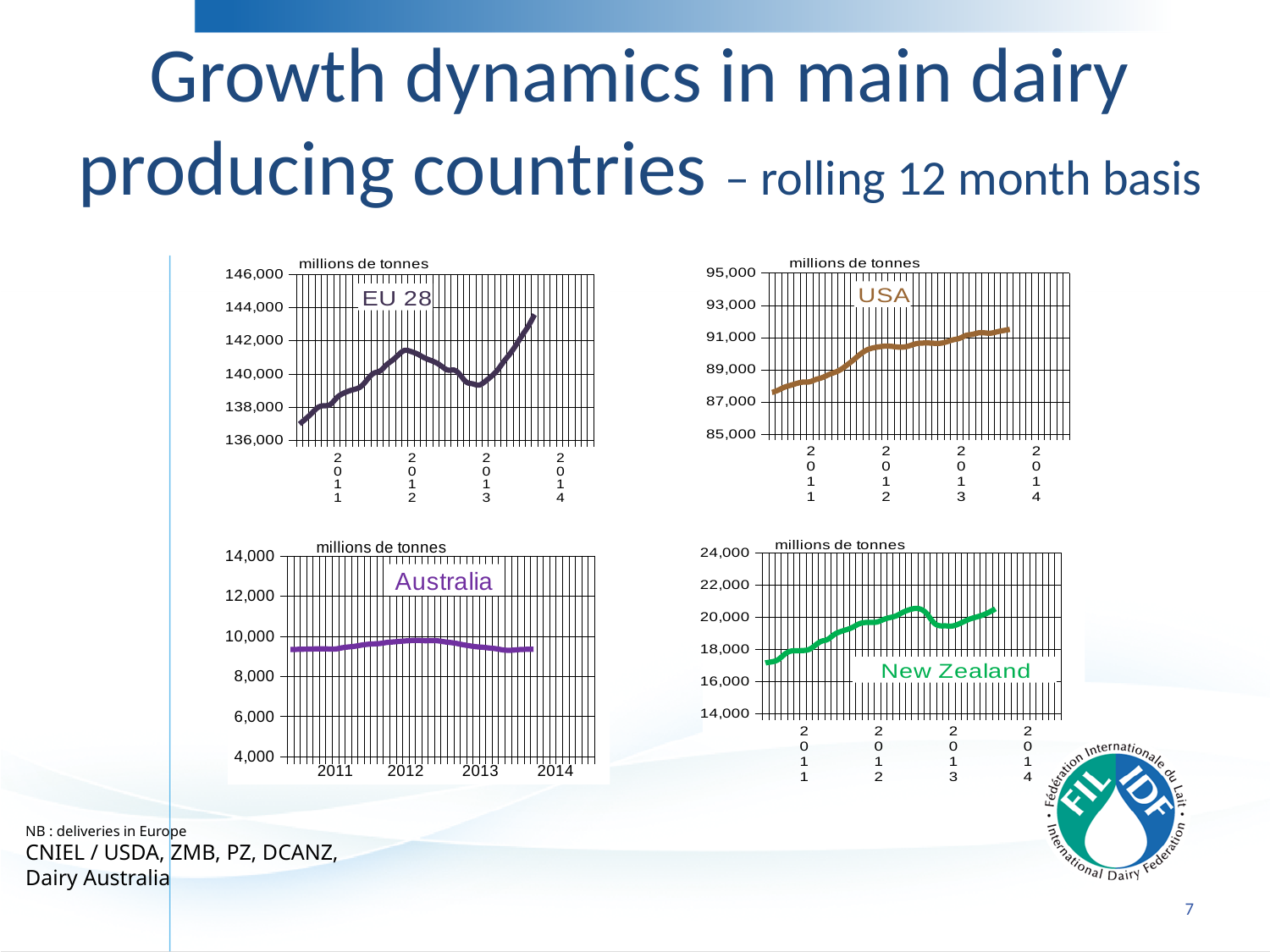
Which country is plotted in the chart at the bottom right of the slide? New Zealand In the USA chart, is the final value in 2014 greater or less than 89,000? greater What unit is shown above each of the four charts? millions de tonnes In the New Zealand chart at the bottom right, is the value at the start of 2011 greater or less than 18,000? less What kind of chart is the EU 28 chart at the top left? line chart In the New Zealand chart, is the peak value reached in 2012 greater or less than 20,000? greater How many charts are shown on the slide? 4 In the USA chart at the top right, does the line rise or fall overall from 2011 to 2014? rise